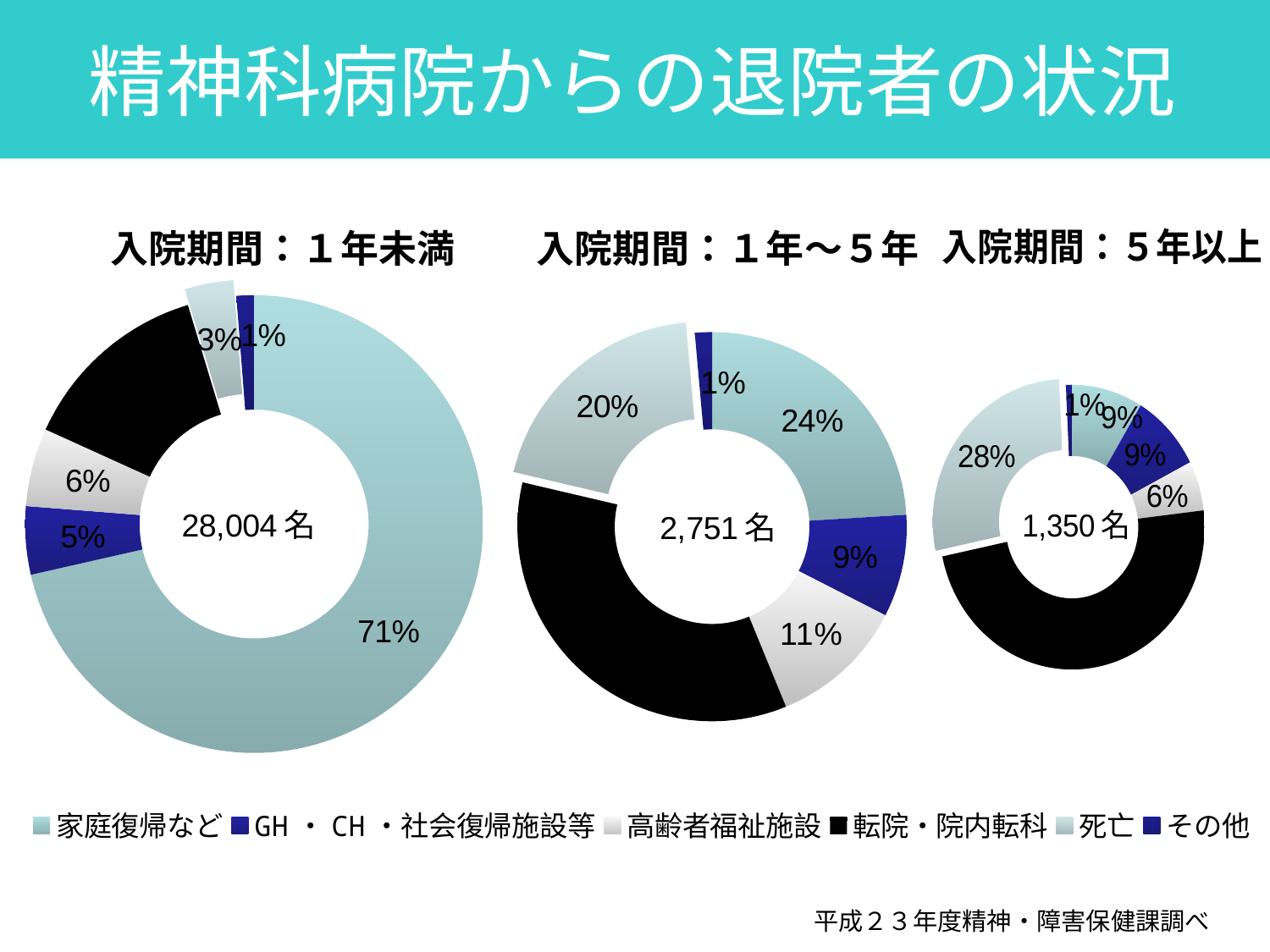
What kind of charts are shown on the slide? Donut (pie) charts In the chart titled 入院期間：５年以上, what is the total number of people shown in the centre? 1,350名 In the chart titled 入院期間：５年以上, what percentage is 死亡? 28% In the chart titled 入院期間：１年未満, what is the total number of people shown in the centre? 28,004名 In the chart titled 入院期間：１年～５年, which is larger: 家庭復帰など or 高齢者福祉施設? 家庭復帰など In the chart titled 入院期間：１年～５年, what percentage is 死亡? 20% In the chart titled 入院期間：５年以上, which category has the largest share? 転院・院内転科 How many entries does the legend list? 6 In the chart titled 入院期間：１年～５年, what is the difference between the 家庭復帰など share and the 死亡 share? 4% In the chart titled 入院期間：１年未満, what percentage is 家庭復帰など? 71% In the chart titled 入院期間：１年未満, which category has the largest share? 家庭復帰など In the chart titled 入院期間：１年未満, what percentage is 高齢者福祉施設? 6%